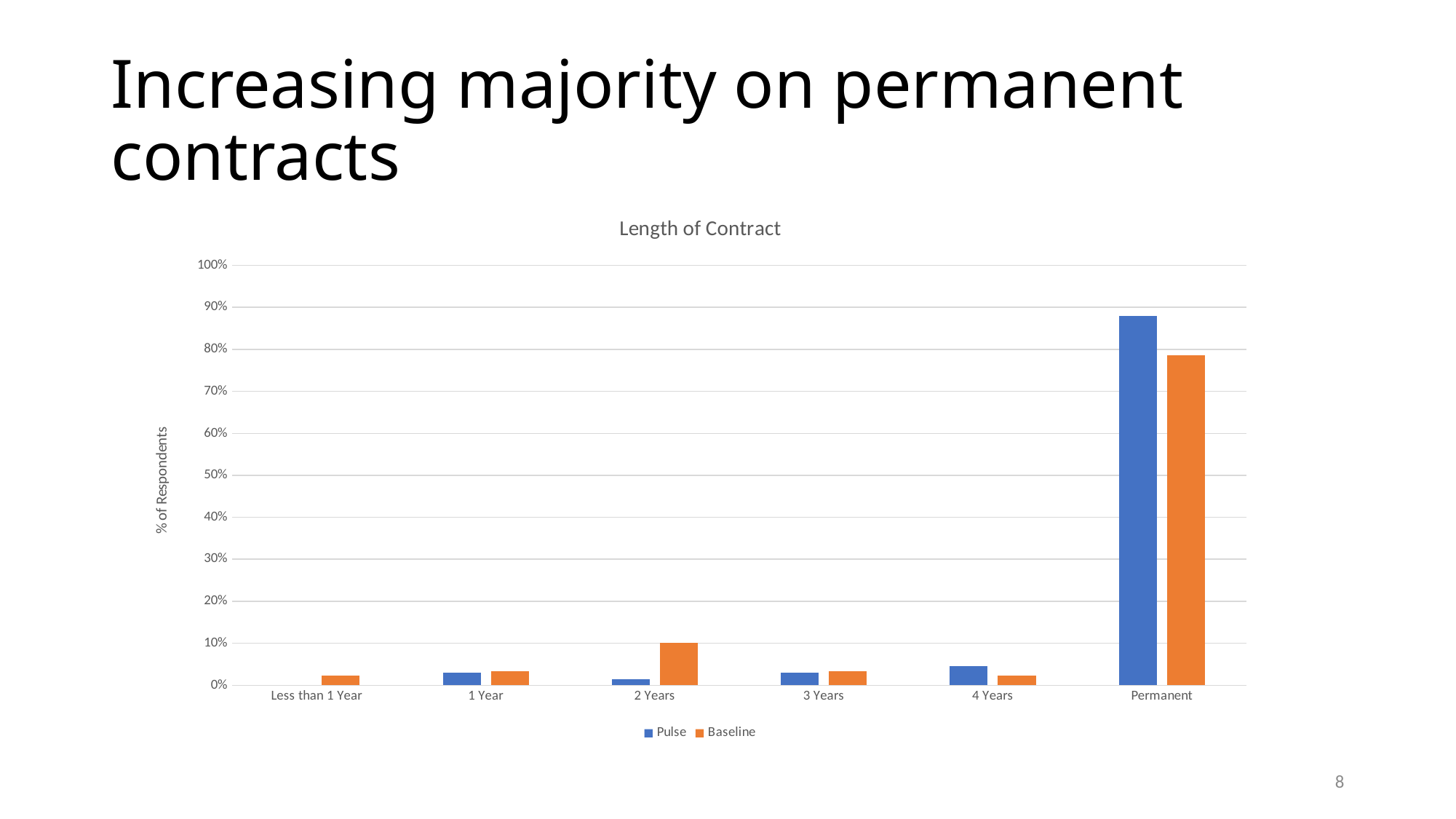
How many series does the legend list? 2 What kind of chart is shown on the slide? Bar chart How many contract-length categories are shown on the x axis? 6 What is the label on the vertical axis? % of Respondents For Permanent, which series has the larger value, Pulse or Baseline? Pulse Which category has the highest Baseline value? Permanent Is the Pulse value for Permanent greater or less than 80%? greater Which category has the highest Pulse value? Permanent For 4 Years, which series has the larger value, Pulse or Baseline? Pulse Is the Baseline value for Permanent greater or less than 70%? greater For 2 Years, which series has the larger value, Pulse or Baseline? Baseline What is the title of the chart? Length of Contract